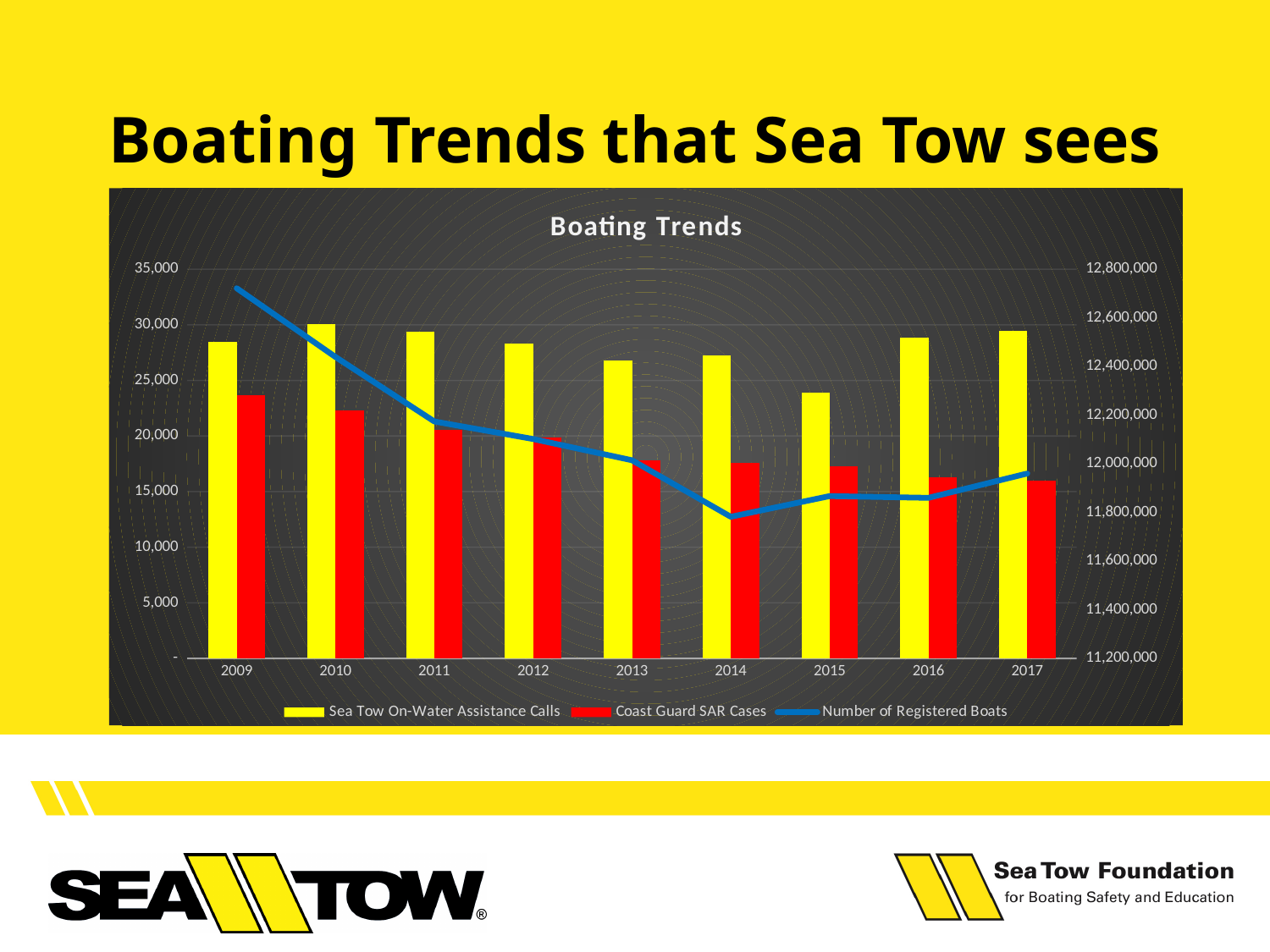
How many series does the chart's legend list? 3 Is the value for Coast Guard SAR Cases in 2009 greater or less than 25,000? less Which colour represents Coast Guard SAR Cases in the chart? Red Is the value for Sea Tow On-Water Assistance Calls in 2010 greater or less than 25,000? greater In which year was the Number of Registered Boats lowest? 2014 In which year were Coast Guard SAR Cases highest? 2009 Which is larger in 2009: Sea Tow On-Water Assistance Calls or Coast Guard SAR Cases? Sea Tow On-Water Assistance Calls What kind of chart is shown on the slide? A combination bar and line chart In which year were Sea Tow On-Water Assistance Calls lowest? 2015 How many years are shown on the x axis of the chart? 9 Is the Number of Registered Boats in 2009 greater or less than 12,600,000? greater What is the title of the chart? Boating Trends